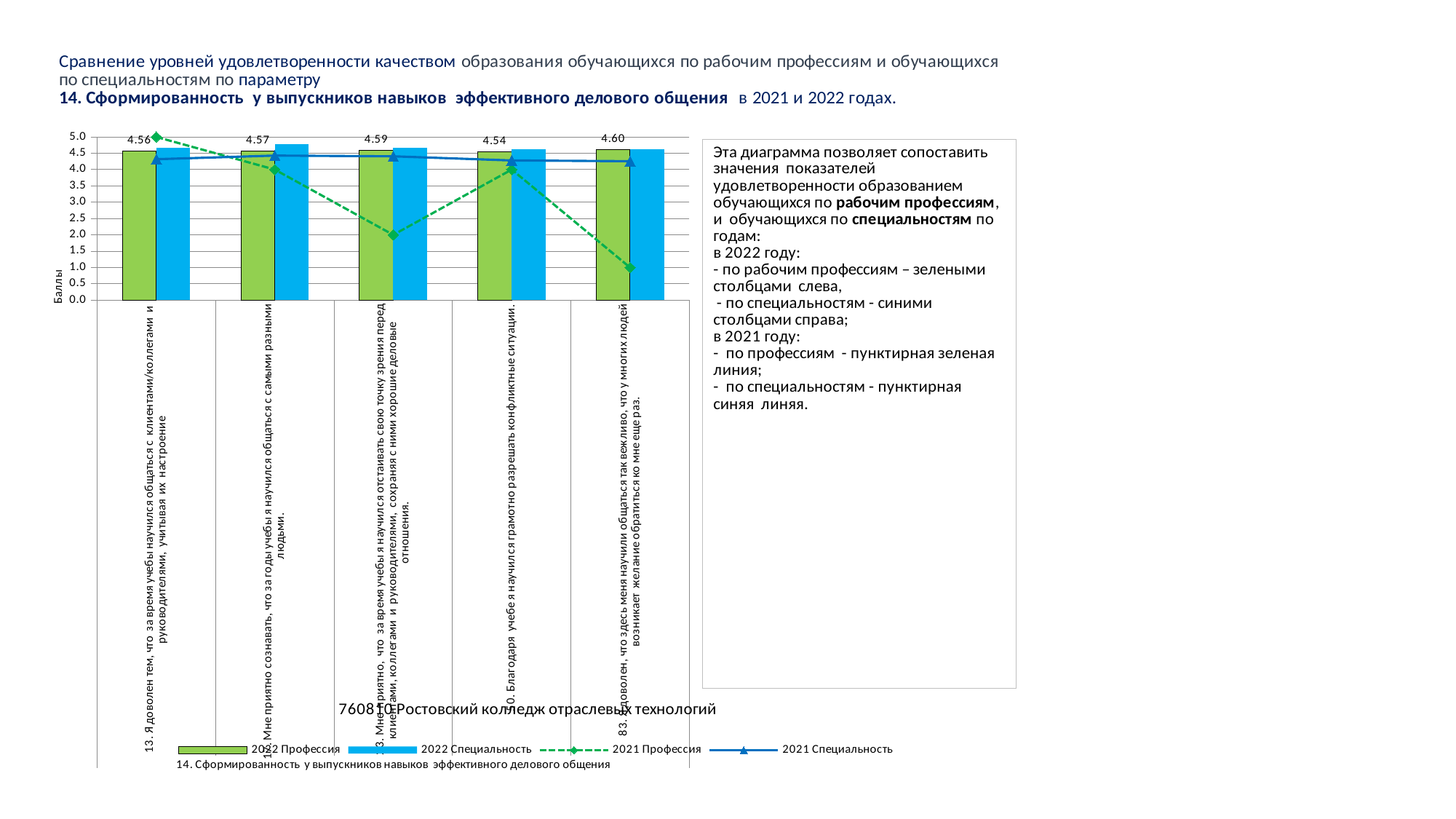
Which category has the highest 2022 Профессия bar? 83. Я доволен, что здесь меня научили общаться так вежливо, что у многих людей возникает желание обратиться ко мне еще раз What kind of chart is shown on the slide? A combined bar and line chart For the 2021 Профессия line, which is larger: the value at the first category (13. Я доволен тем...) or at the third category (Мне приятно, что за время учебы я научился отстаивать свою точку зрения...)? The first category (13. Я доволен тем...) What is the value of the 2022 Профессия bar for the category "Благодаря учебе я научился грамотно разрешать конфликтные ситуации"? 4.54 How many categories are shown on the x axis of the chart? 5 Is the 2022 Специальность bar for the category "Мне приятно сознавать, что за годы учебы я научился общаться с самыми разными людьми" greater or less than 4.5? greater How many series does the chart legend list? 4 Which category has the lowest 2022 Профессия bar? Благодаря учебе я научился грамотно разрешать конфликтные ситуации What is the value of the 2022 Профессия bar for the category "83. Я доволен, что здесь меня научили общаться так вежливо, что у многих людей возникает желание обратиться ко мне еще раз"? 4.60 What is the difference between the highest and lowest 2022 Профессия bar values? 0.06 What is the value of the 2022 Профессия bar for the category "13. Я доволен тем, что за время учебы научился общаться с клиентами/коллегами и руководителями, учитывая их настроение"? 4.56 What is the value of the 2021 Профессия line at the category "83. Я доволен, что здесь меня научили общаться так вежливо..."? 1.0